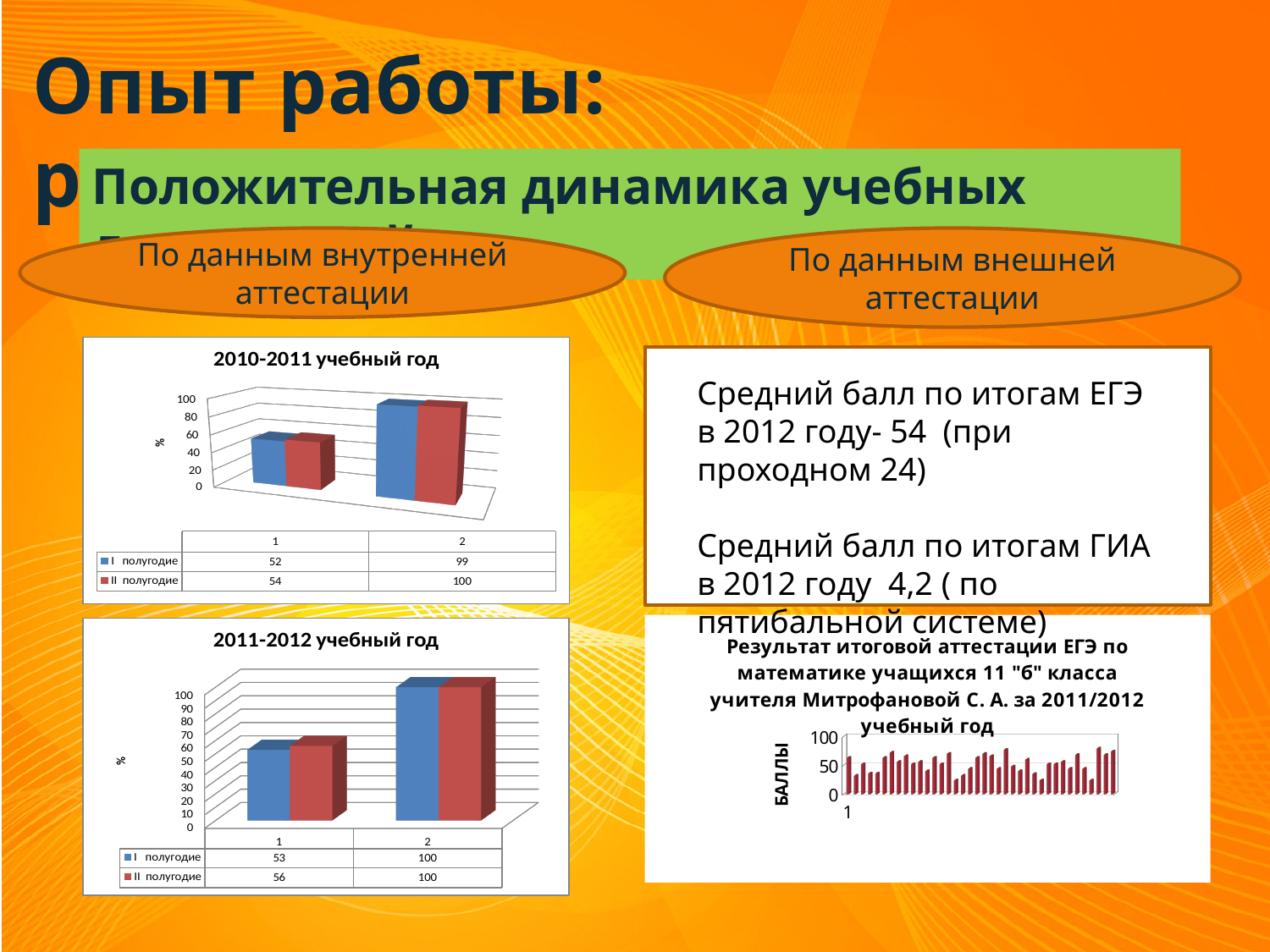
In the chart titled "2011-2012 учебный год", what is the difference between "II полугодие" and "I полугодие" for category 1? 3 In the chart titled "2010-2011 учебный год", which series has the higher value for category 2, "I полугодие" or "II полугодие"? II полугодие In the chart titled "2011-2012 учебный год", what is the value of "I полугодие" for category 2? 100 In the chart titled "2011-2012 учебный год", how many series does the legend list? 2 In the chart titled "2011-2012 учебный год", what is the value of "II полугодие" for category 1? 56 In the chart titled "2010-2011 учебный год", what is the value of "II полугодие" for category 2? 100 In the chart titled "2010-2011 учебный год", what is the value of "I полугодие" for category 1? 52 In the chart at the bottom right of the slide (ЕГЭ results), what label is shown on the vertical axis? БАЛЛЫ What kind of chart is the one titled "2010-2011 учебный год"? Bar chart In the chart titled "2010-2011 учебный год", what is the difference between "II полугодие" and "I полугодие" for category 1? 2 In the chart titled "2011-2012 учебный год", how many categories are shown on the x axis? 2 In the chart titled "2010-2011 учебный год", what label is shown on the vertical axis? %